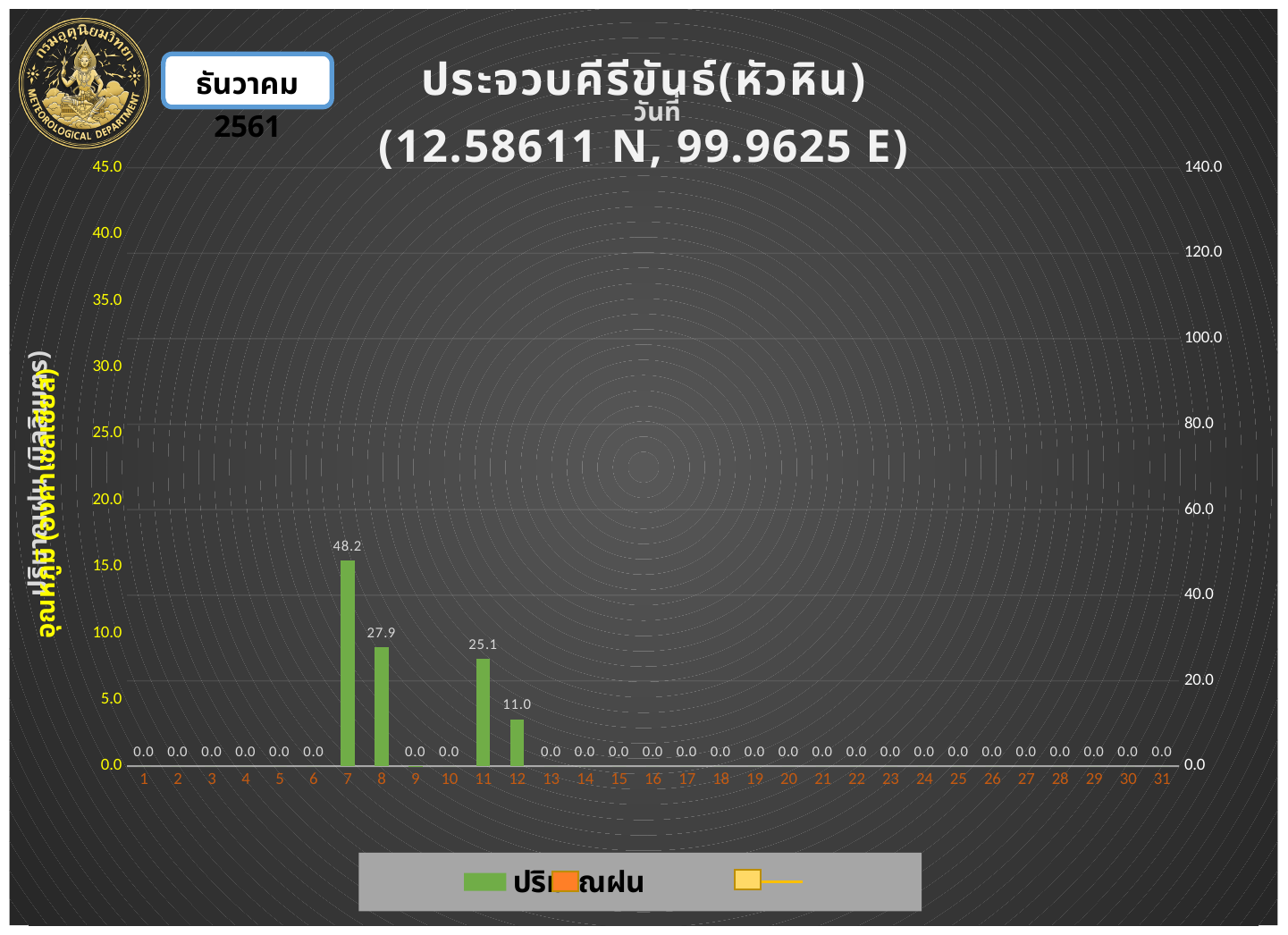
Which is larger, the value for day 8 or the value for day 11? day 8 What is the value for day 11? 25.1 What is the value for day 20? 0.0 What is the difference between the values for day 11 and day 12? 14.1 What is the value for day 12? 11.0 What is the value for day 8? 27.9 What is the value for day 7? 48.2 What is the difference between the values for day 7 and day 8? 20.3 What kind of chart is shown? bar chart Which day has the highest value? 7 How many days are shown on the x axis? 31 What coordinates are given in the chart title? 12.58611 N, 99.9625 E